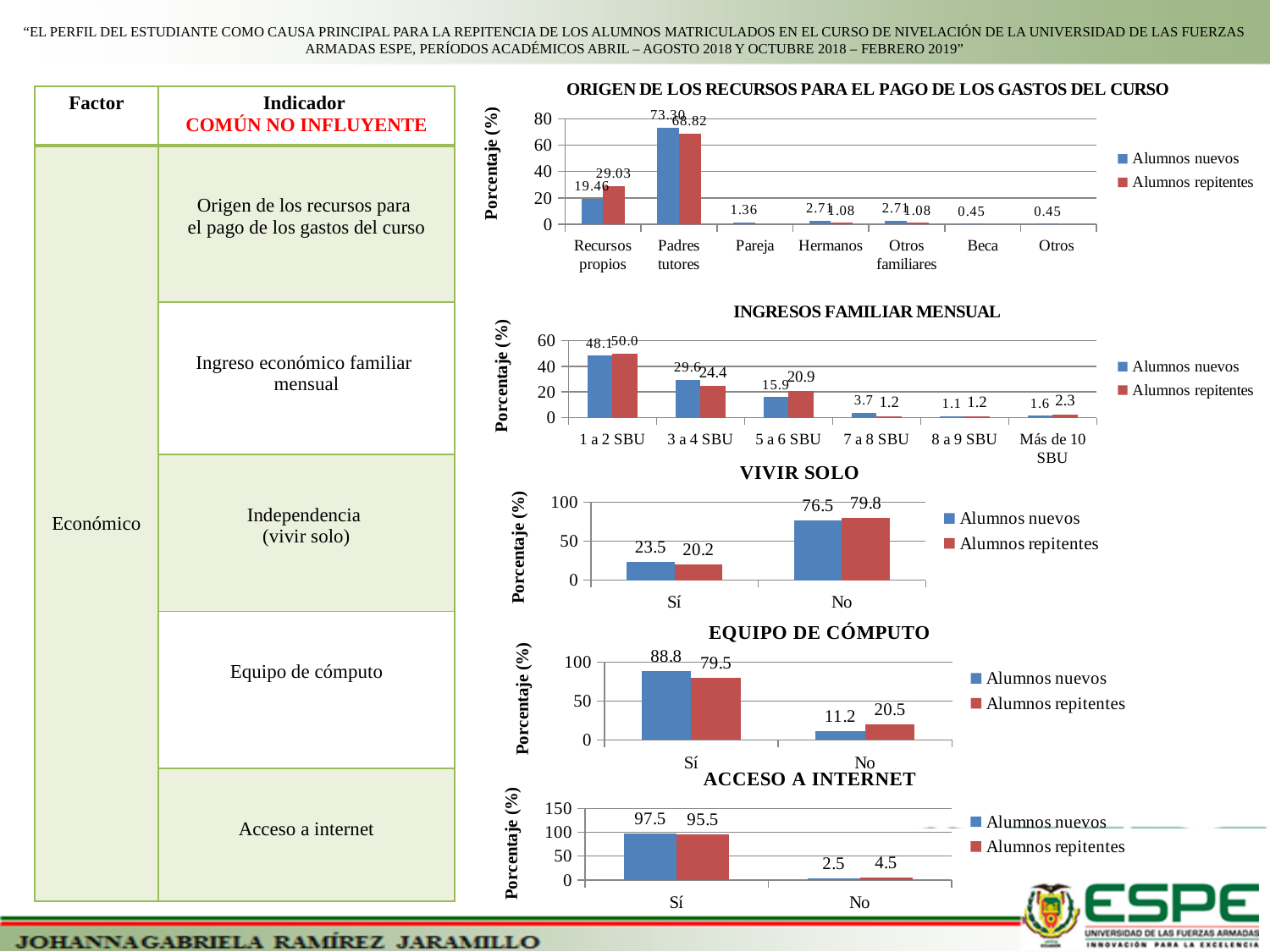
In the 'ACCESO A INTERNET' chart, what is the difference between Alumnos nuevos and Alumnos repitentes in the 'Sí' category? 2.0 In the 'VIVIR SOLO' chart, what is the value for Alumnos nuevos in the 'No' category? 76.5 In the 'ORIGEN DE LOS RECURSOS PARA EL PAGO DE LOS GASTOS DEL CURSO' chart, which category has the highest value for Alumnos nuevos? Padres tutores What type of chart is the 'EQUIPO DE CÓMPUTO' chart? Bar chart How many categories are shown on the x axis of the 'INGRESOS FAMILIAR MENSUAL' chart? 6 In the 'VIVIR SOLO' chart, which is larger in the 'Sí' category: Alumnos nuevos or Alumnos repitentes? Alumnos nuevos In the 'INGRESOS FAMILIAR MENSUAL' chart, is the value for Alumnos nuevos in '3 a 4 SBU' greater or less than 20? greater In the 'ACCESO A INTERNET' chart, what is the value for Alumnos nuevos in the 'Sí' category? 97.5 In the 'INGRESOS FAMILIAR MENSUAL' chart, which category has the highest value for Alumnos repitentes? 1 a 2 SBU In the 'EQUIPO DE CÓMPUTO' chart, what is the value for Alumnos repitentes in the 'Sí' category? 79.5 How many series does the legend of the 'ACCESO A INTERNET' chart list? 2 In the 'EQUIPO DE CÓMPUTO' chart, what is the difference between Alumnos nuevos and Alumnos repitentes in the 'No' category? 9.3